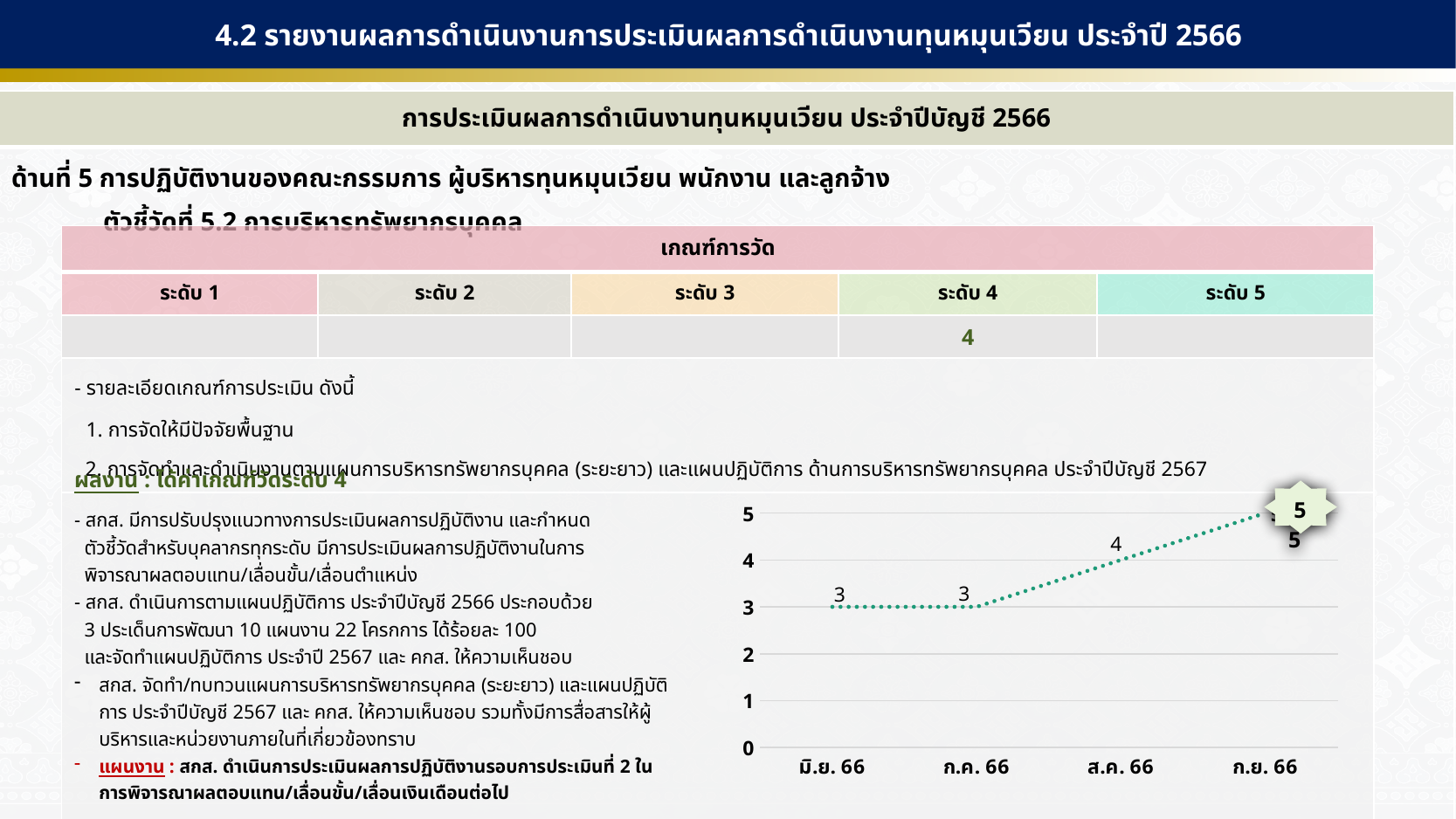
What is the maximum value shown on the y axis of the line chart? 5 What is the difference between the values for ส.ค. 66 and ก.ค. 66 in the line chart? 1 What is the value for มิ.ย. 66 in the line chart? 3 What is the value for ก.ย. 66 in the line chart? 5 Which is larger in the line chart, the value for ส.ค. 66 or the value for ก.ค. 66? ส.ค. 66 Which month has the highest value in the line chart? ก.ย. 66 Do the values in the line chart rise or fall from มิ.ย. 66 to ก.ย. 66? rise How many data points are plotted in the line chart? 4 What is the value for ส.ค. 66 in the line chart? 4 What is the value for ก.ค. 66 in the line chart? 3 What is the difference between the values for ก.ย. 66 and มิ.ย. 66 in the line chart? 2 What kind of chart is shown on the slide? line chart